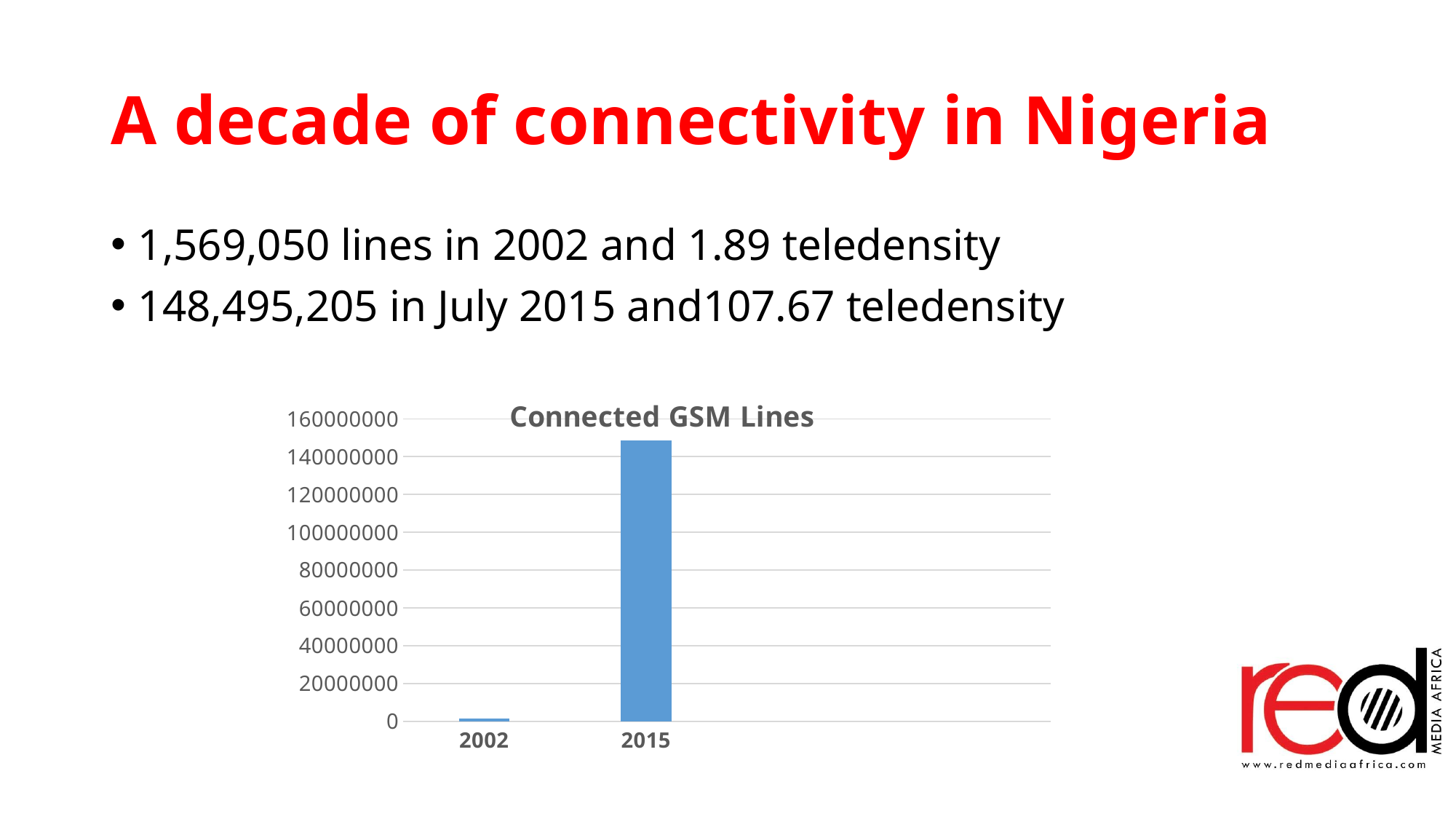
Which year has the lowest number of connected GSM lines in the chart? 2002 How many categories are plotted on the x axis of the chart? 2 Is the value for 2002 greater or less than 20000000? less Do the values rise or fall from 2002 to 2015? rise Using the figures stated on the slide, what is the difference between the number of lines in 2015 and in 2002? 146,926,155 According to the slide, how many lines were there in 2002? 1,569,050 Which bar is taller, 2002 or 2015? 2015 What is the title of the chart? Connected GSM Lines Which year has the highest number of connected GSM lines in the chart? 2015 Is the value for 2015 greater or less than 140000000? greater What kind of chart is shown on the slide? bar chart According to the slide, how many lines were there in July 2015? 148,495,205